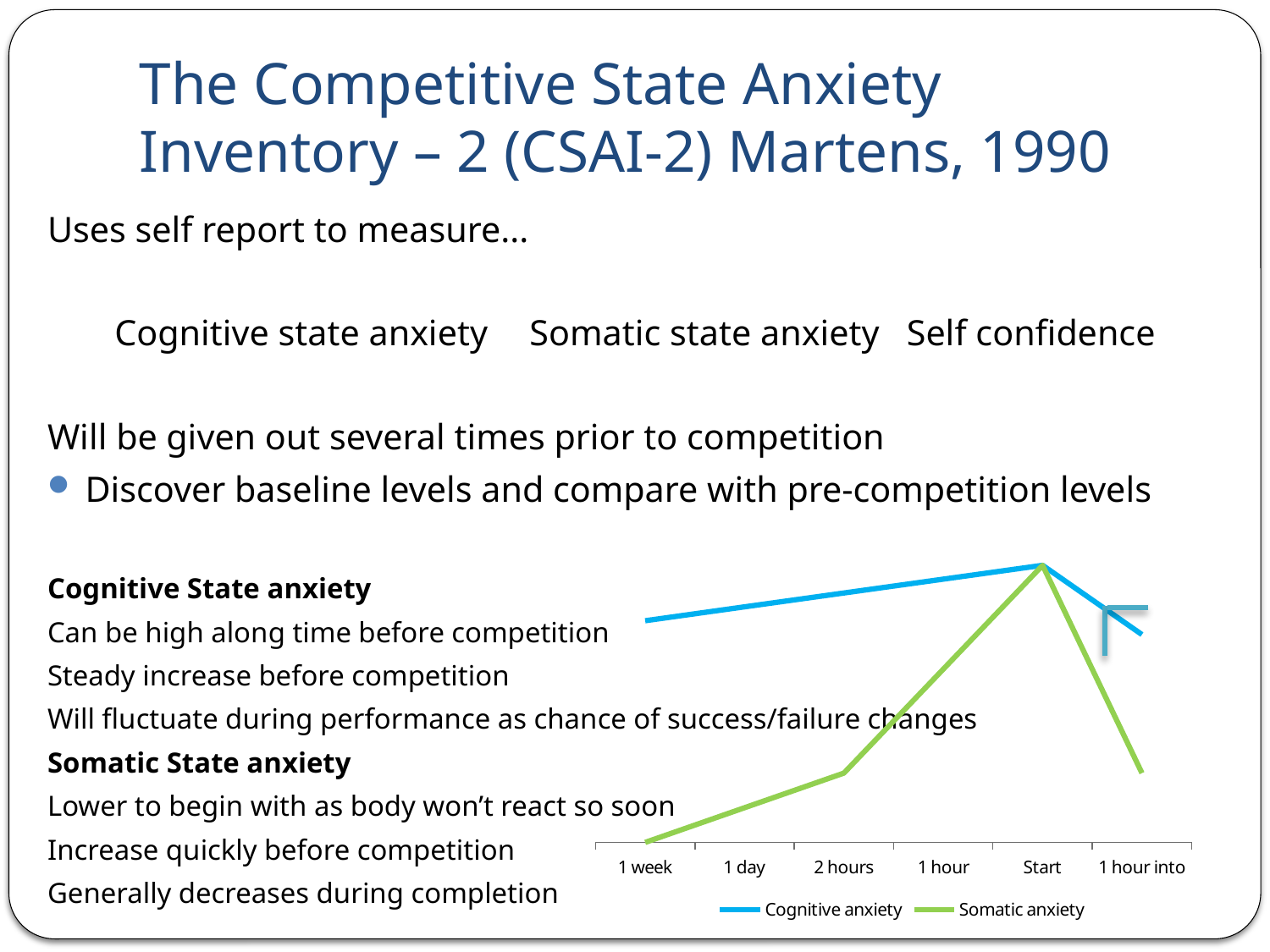
At 1 hour into, which series is higher: Cognitive anxiety or Somatic anxiety? Cognitive anxiety Does the Cognitive anxiety line rise or fall between Start and 1 hour into? Fall What kind of chart is shown on the slide? Line chart What is the first category label on the chart's x axis? 1 week How many series does the chart's legend list? 2 At which x-axis category does the Cognitive anxiety line reach its highest point? Start At 1 week, which series is higher: Cognitive anxiety or Somatic anxiety? Cognitive anxiety Does the Somatic anxiety line rise or fall between 1 week and Start? Rise At which x-axis category does the Somatic anxiety line reach its highest point? Start Which series is drawn in green in the chart? Somatic anxiety How many categories are labelled on the chart's x axis? 6 At which x-axis category is the Somatic anxiety line at its lowest? 1 week